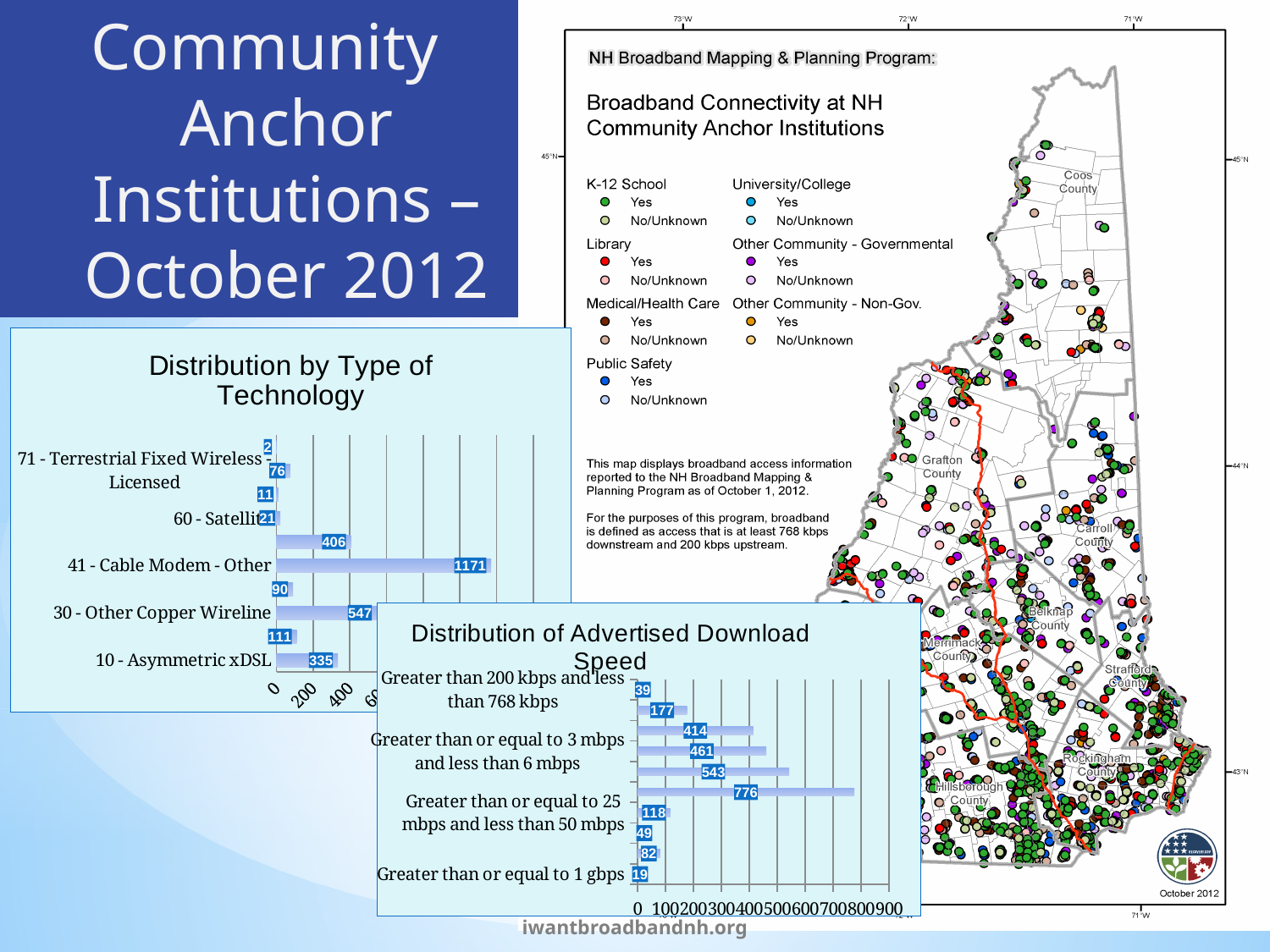
In the 'Distribution of Advertised Download Speed' chart, which has the larger value: 'Greater than 200 kbps and less than 768 kbps' or 'Greater than or equal to 1 gbps'? Greater than 200 kbps and less than 768 kbps In the 'Distribution of Advertised Download Speed' chart, what is the value for 'Greater than or equal to 3 mbps and less than 6 mbps'? 461 In the 'Distribution by Type of Technology' chart, what is the difference between the values for '30 - Other Copper Wireline' and '10 - Asymmetric xDSL'? 212 In the 'Distribution of Advertised Download Speed' chart, what is the value for 'Greater than or equal to 1 gbps'? 19 In the 'Distribution of Advertised Download Speed' chart, what is the value for 'Greater than or equal to 25 mbps and less than 50 mbps'? 118 How many bars are plotted in the 'Distribution by Type of Technology' chart? 10 In the 'Distribution of Advertised Download Speed' chart, what is the largest value shown on any bar? 776 In the 'Distribution by Type of Technology' chart, what is the value for '41 - Cable Modem - Other'? 1171 In the 'Distribution by Type of Technology' chart, what is the value for '60 - Satellite'? 21 In the 'Distribution by Type of Technology' chart, what is the largest value shown on any bar? 1171 In the 'Distribution by Type of Technology' chart, what is the value for '10 - Asymmetric xDSL'? 335 What type of chart is the 'Distribution of Advertised Download Speed' chart? Bar chart